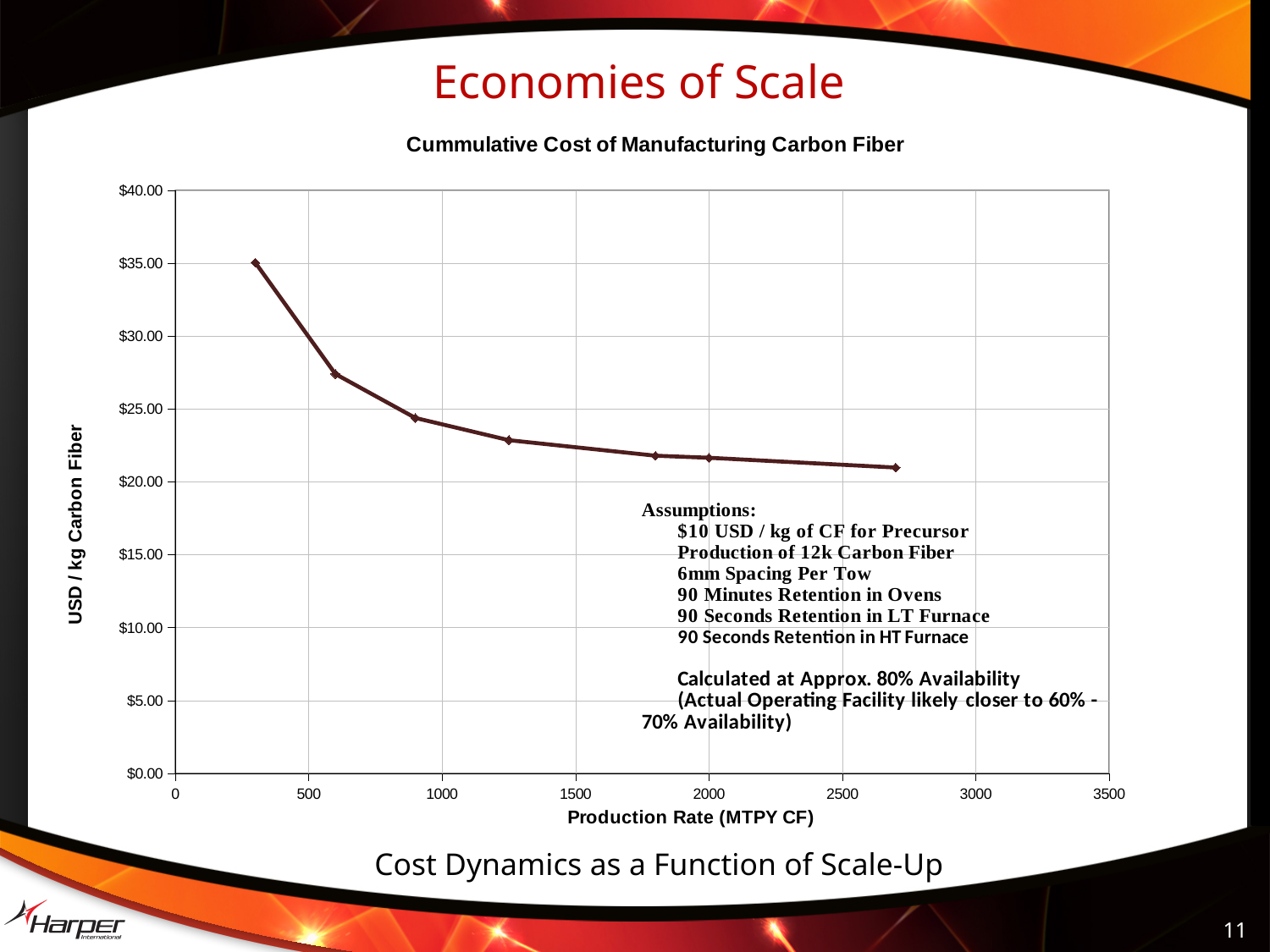
What kind of chart is shown on the slide? line chart What is the highest value shown on the y axis? $40.00 Does the cost per kg rise or fall as the production rate increases? fall Is the value for the first data point (around 300 MTPY) greater or less than $30.00? greater Which data point has the highest cost per kg: the one at the lowest production rate or the one at the highest production rate? the one at the lowest production rate What is the label of the x axis? Production Rate (MTPY CF) Is the value for the data point at around 1250 MTPY greater or less than $25.00? less Is the value for the data point at around 600 MTPY greater or less than $25.00? greater How many data points are plotted on the line? 7 What is the title of the chart? Cummulative Cost of Manufacturing Carbon Fiber